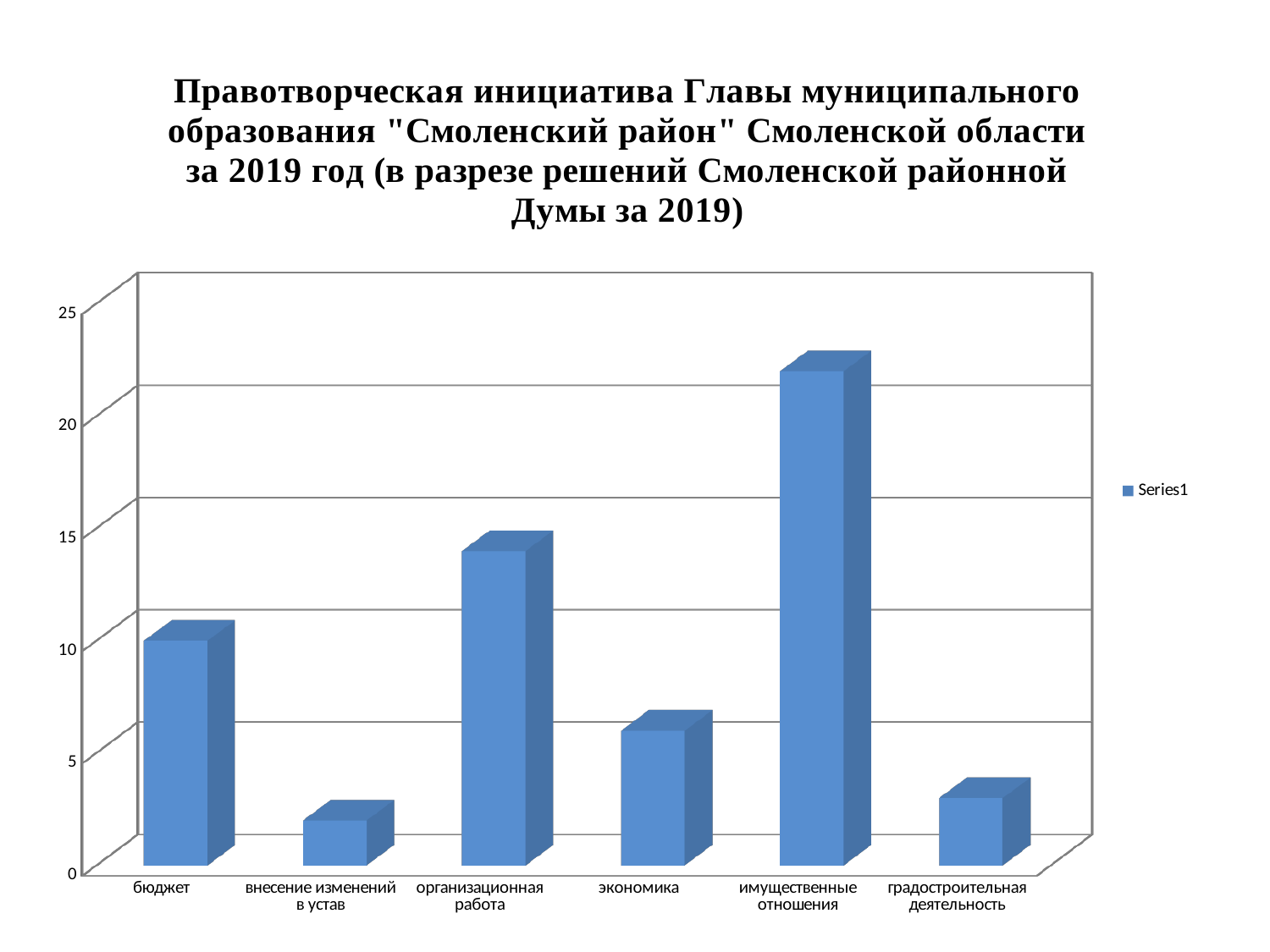
Is the value for имущественные отношения greater or less than 20? greater Is the value for градостроительная деятельность greater or less than 5? less Is the value for организационная работа greater or less than 15? less Which category has the highest bar? имущественные отношения How many series does the legend list? 1 Which category has the lowest bar? внесение изменений в устав Which is larger, the value for бюджет or the value for экономика? бюджет Which is larger, the value for организационная работа or the value for бюджет? организационная работа How many categories are shown on the x axis of the chart? 6 What kind of chart is shown on the slide? bar chart What is the name of the series shown in the legend? Series1